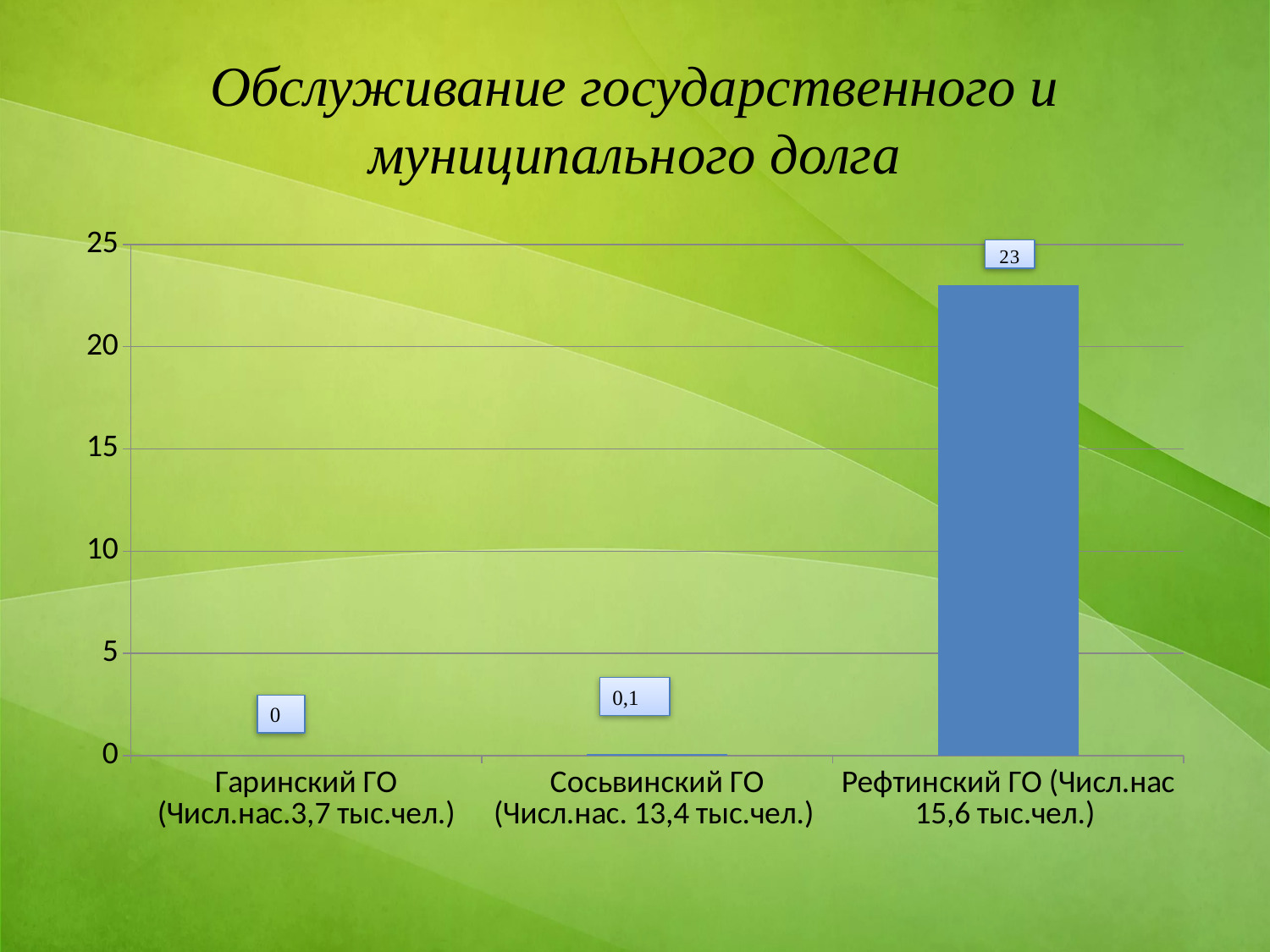
Do the values rise or fall from left to right along the x axis? rise What is the title of the slide? Обслуживание государственного и муниципального долга Which is larger, the value for Сосьвинский ГО or the value for Гаринский ГО? Сосьвинский ГО Is the value for Рефтинский ГО greater or less than 20? greater How many categories are shown on the x axis? 3 What is the value for Гаринский ГО? 0 What is the value for Сосьвинский ГО? 0,1 What is the difference between the values for Рефтинский ГО and Сосьвинский ГО? 22,9 What is the value for Рефтинский ГО? 23 Which category has the highest value? Рефтинский ГО What kind of chart is shown on the slide? bar chart Which category has the lowest value? Гаринский ГО